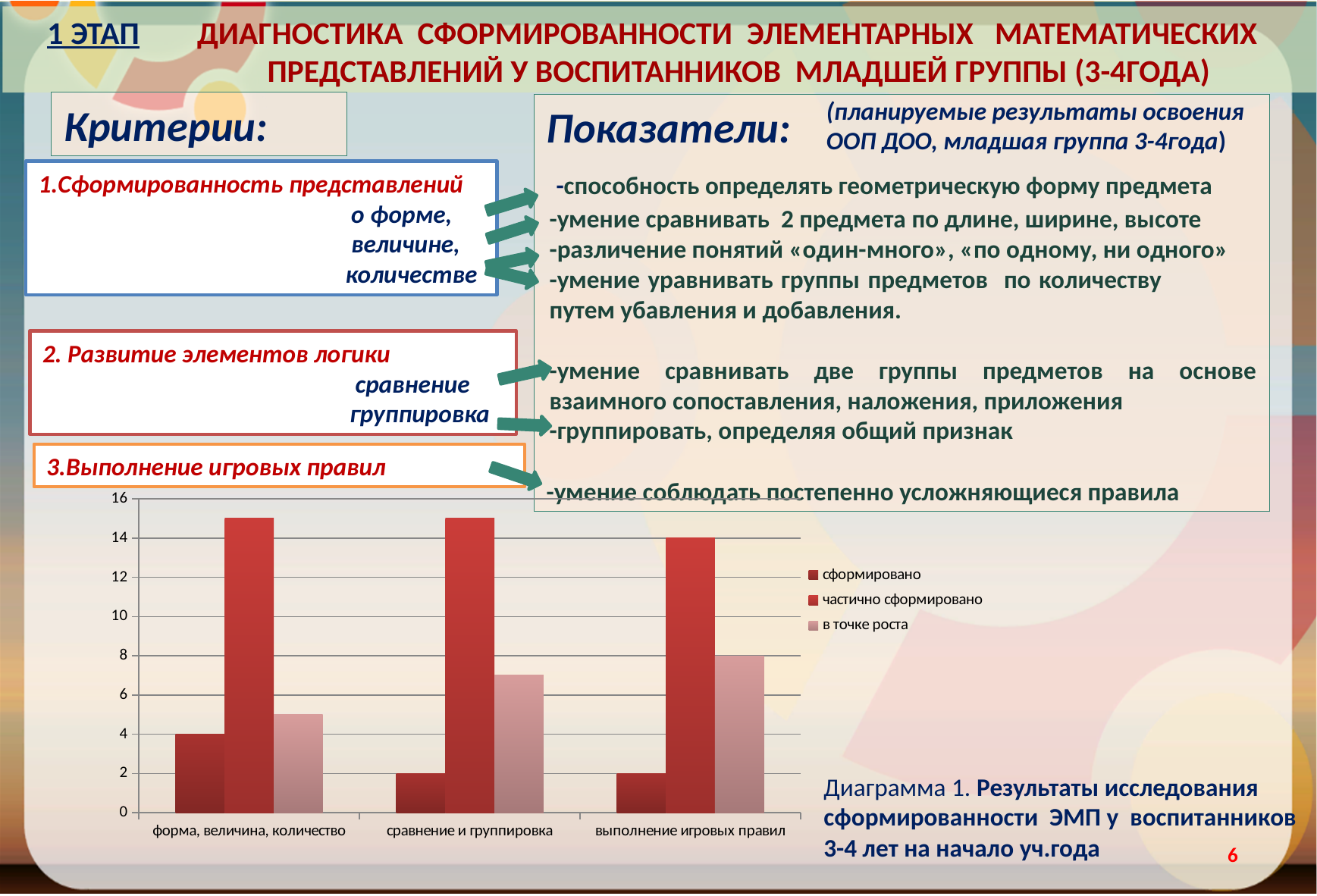
What is the value of "в точке роста" for "выполнение игровых правил"? 8 What kind of chart is shown on the slide? bar chart Is the value of "в точке роста" for "сравнение и группировка" greater or less than 6? greater Is the value of "частично сформировано" for "форма, величина, количество" greater or less than 14? greater What is the value of "сформировано" for "форма, величина, количество"? 4 What is the value of "частично сформировано" for "выполнение игровых правил"? 14 Which category has the highest value for "сформировано"? форма, величина, количество What is the difference between "в точке роста" and "сформировано" for "выполнение игровых правил"? 6 How many categories are shown on the x axis of the chart? 3 What is the value of "сформировано" for "выполнение игровых правил"? 2 For "сравнение и группировка", which is larger: "частично сформировано" or "в точке роста"? частично сформировано How many series does the chart legend list? 3